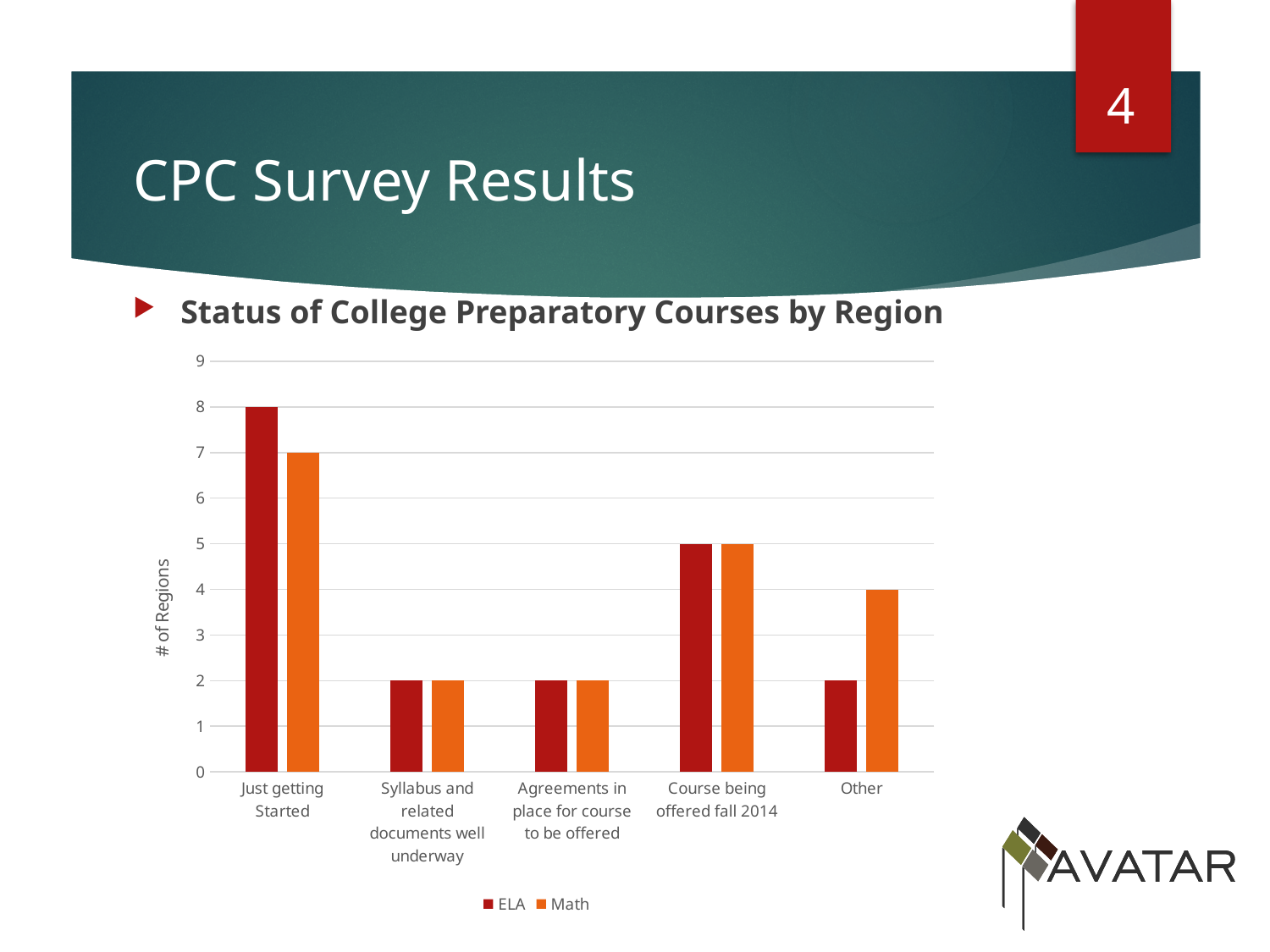
How many categories are shown on the x axis? 5 What is the ELA value for 'Just getting Started'? 8 How many series does the legend list? 2 Which category has the lowest Math value? Syllabus and related documents well underway and Agreements in place for course to be offered (both 2) What kind of chart is shown on the slide? bar chart What colour are the Math bars? orange What is the label of the y axis? # of Regions Which category has the highest ELA value? Just getting Started What is the Math value for 'Other'? 4 What is the Math value for 'Course being offered fall 2014'? 5 What is the difference between the ELA and Math values for 'Just getting Started'? 1 For 'Other', which is larger, the ELA value or the Math value? Math